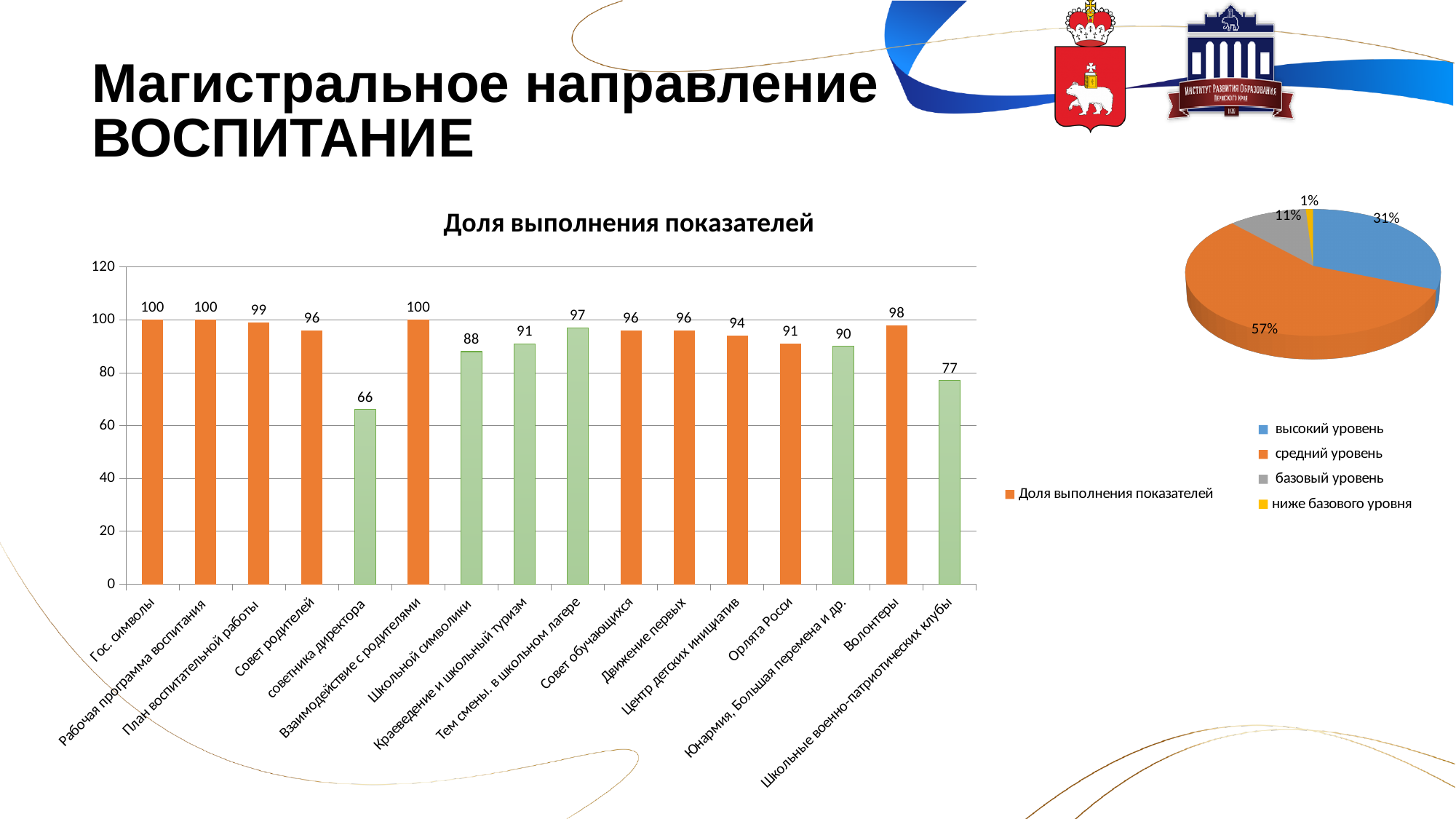
On the bar chart 'Доля выполнения показателей', how many categories are shown on the x axis? 16 On the bar chart 'Доля выполнения показателей', which is larger: the value for 'Центр детских инициатив' or the value for 'Орлята Росси'? Центр детских инициатив On the bar chart 'Доля выполнения показателей', which category has the lowest value? советника директора What kind of chart is the chart titled 'Доля выполнения показателей'? bar chart On the bar chart 'Доля выполнения показателей', what is the value for 'Юнармия, Большая перемена и др.'? 90 On the bar chart 'Доля выполнения показателей', what is the value for 'советника директора'? 66 On the bar chart 'Доля выполнения показателей', what is the difference between the values for 'Школьной символики' and 'Школьные военно-патриотических клубы'? 11 On the pie chart on the right of the slide, which slice is the smallest? ниже базового уровня On the bar chart 'Доля выполнения показателей', what is the value for 'Волонтеры'? 98 On the pie chart on the right of the slide, what share does 'средний уровень' have? 57% How many entries does the legend of the pie chart on the right of the slide list? 4 On the pie chart on the right of the slide, what is the difference between the shares of 'высокий уровень' and 'базовый уровень'? 20%